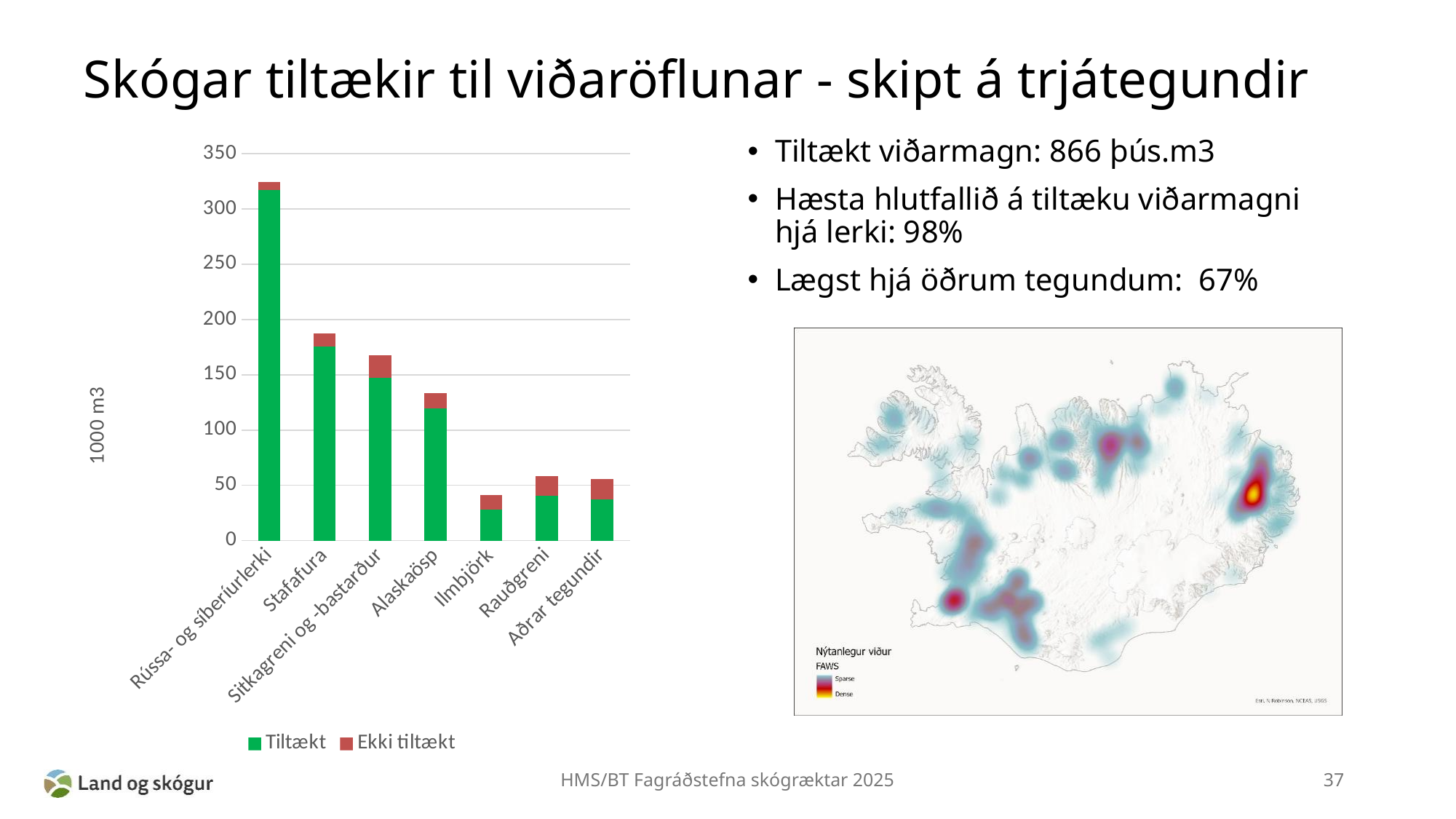
Is the total bar for Alaskaösp greater or less than 100? greater Which has a taller total bar, Stafafura or Sitkagreni og -bastarður? Stafafura Which category has the shortest bar in the chart? Ilmbjörk How many tree species categories are shown on the x axis of the bar chart? 7 Is the total bar for Ilmbjörk greater or less than 50? less What is the label on the y axis of the bar chart? 1000 m3 Is the total bar for Stafafura greater or less than 200? less What kind of chart is shown on the left of the slide? bar chart Which colour represents the Tiltækt series in the bar chart? green How many series does the legend of the bar chart list? 2 Which category has the tallest bar in the chart? Rússa- og síberíurlerki